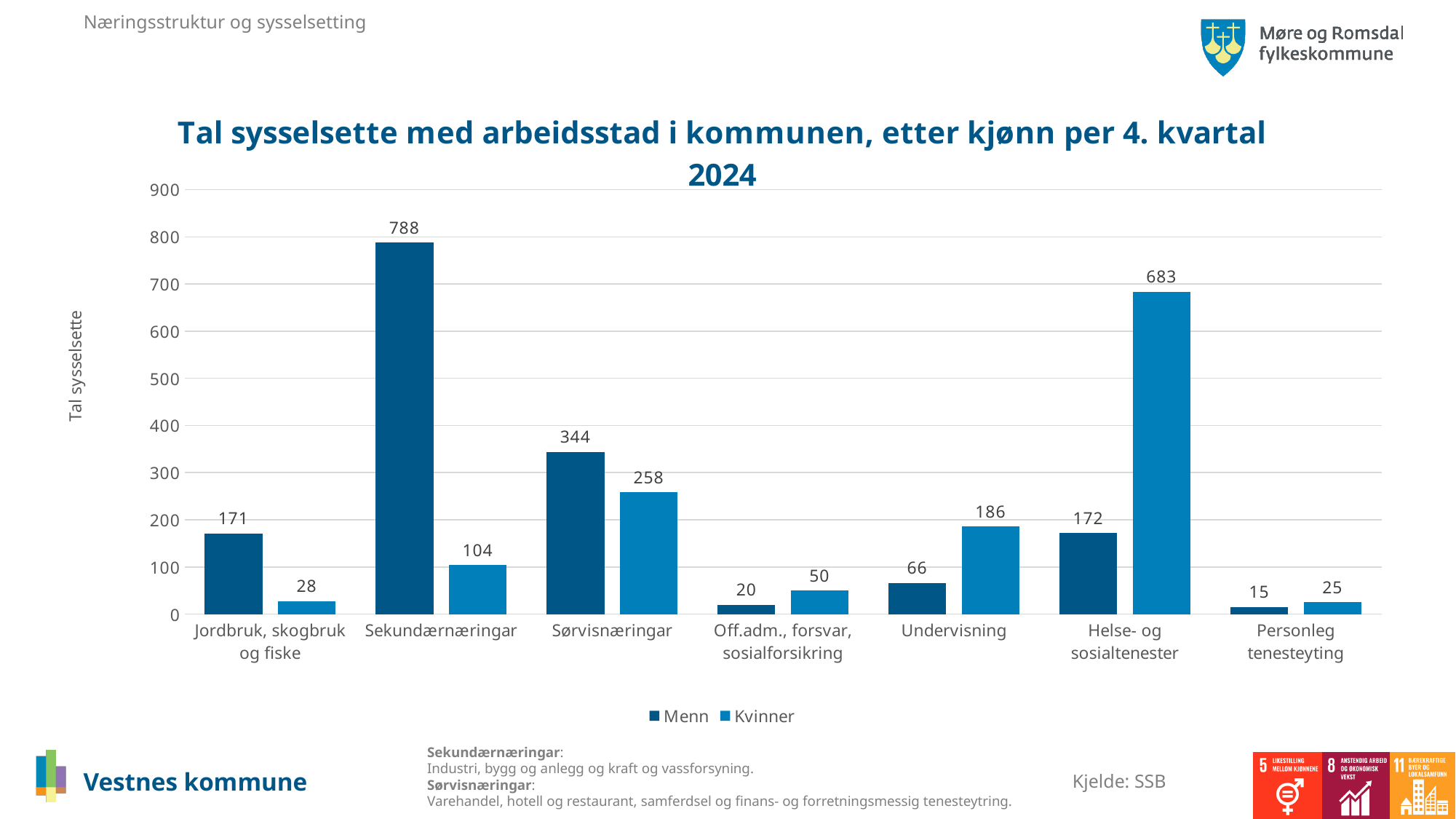
Which category has the lowest value for Kvinner? Personleg tenesteyting What is the label of the y axis? Tal sysselsette What is the difference between Menn and Kvinner in Sørvisnæringar? 86 What is the value for Kvinner in Helse- og sosialtenester? 683 How many series does the legend list? 2 Which category has the highest value for Menn? Sekundærnæringar How many categories are shown on the x axis? 7 Which is larger in Undervisning, Menn or Kvinner? Kvinner What is the value for Menn in Sekundærnæringar? 788 What is the value for Kvinner in Jordbruk, skogbruk og fiske? 28 Is the value for Kvinner in Sekundærnæringar greater or less than 200? less What kind of chart is shown on the slide? Bar chart